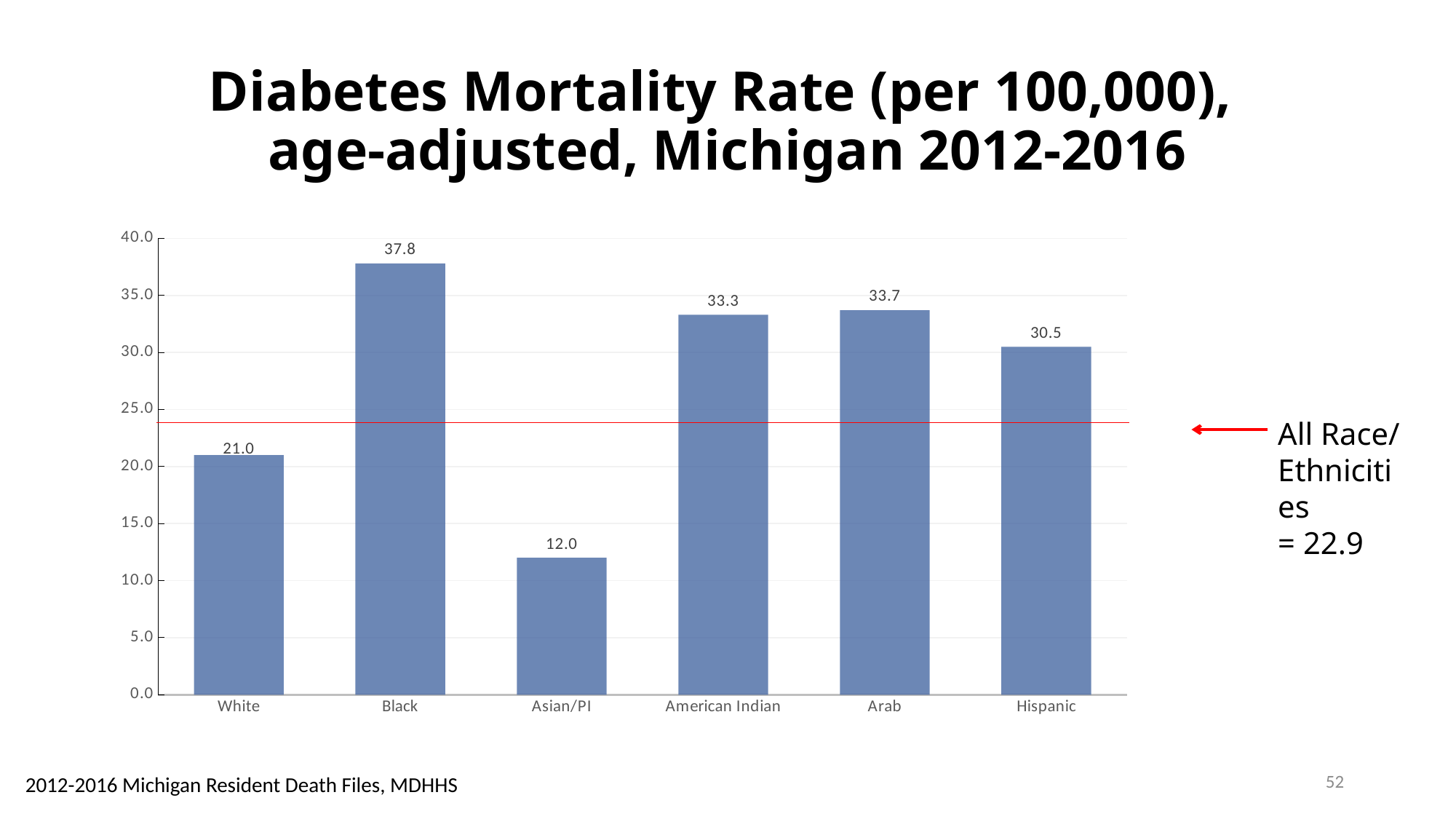
How many race/ethnicity categories are shown in the chart? 6 Which race/ethnicity group has the highest diabetes mortality rate? Black Which race/ethnicity group has the lowest diabetes mortality rate? Asian/PI What kind of chart is shown on the slide? Bar chart What is the diabetes mortality rate for all race/ethnicities combined, as indicated by the red line? 22.9 What is the diabetes mortality rate for Asian/PI residents? 12.0 Which group has a higher diabetes mortality rate, American Indian or Hispanic? American Indian What is the diabetes mortality rate for Hispanic residents? 30.5 What is the difference between the diabetes mortality rates for Black and White residents? 16.8 Is the value for White greater or less than 25.0? less What is the diabetes mortality rate for Black residents? 37.8 What is the data source cited at the bottom of the slide? 2012-2016 Michigan Resident Death Files, MDHHS